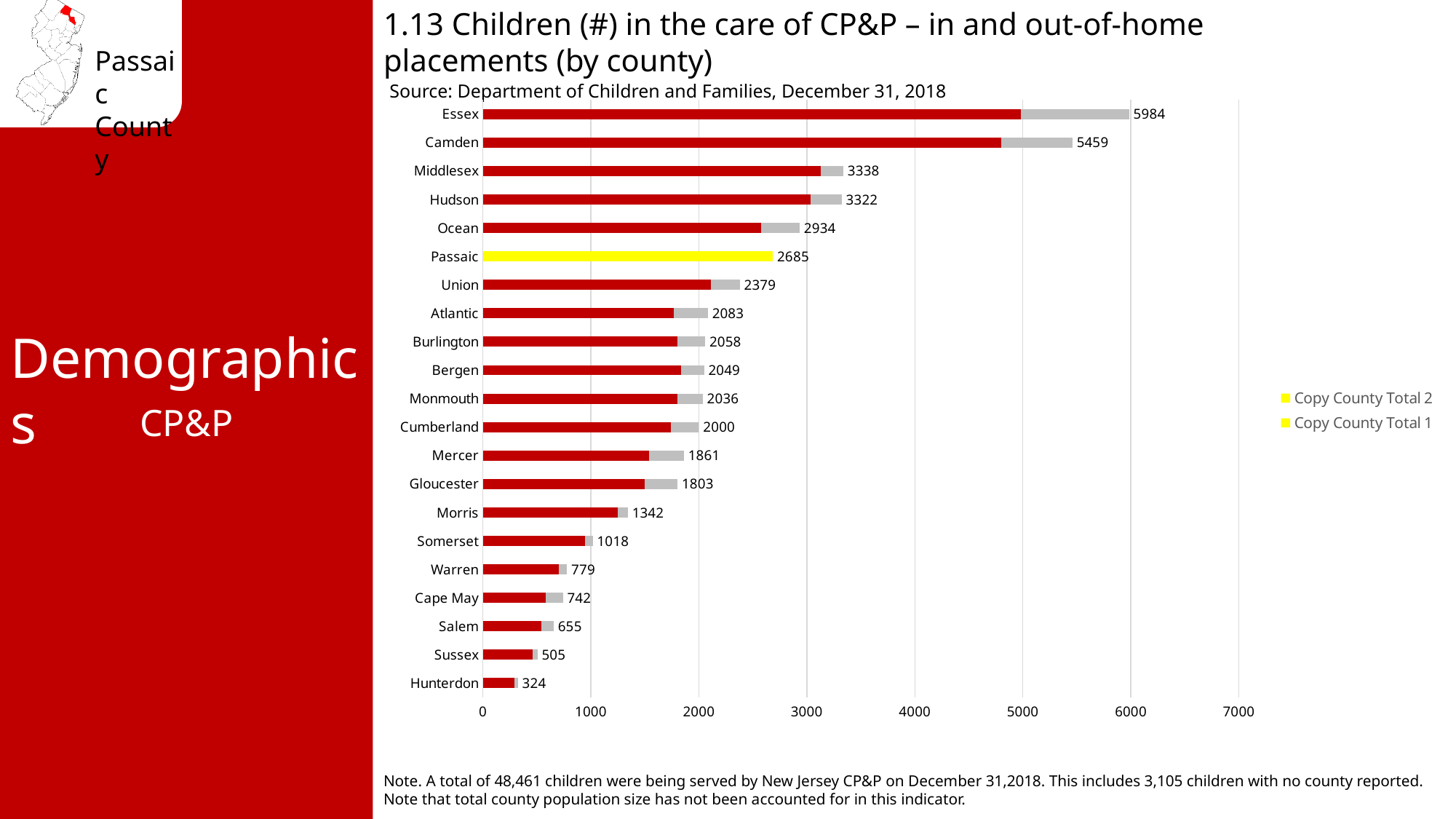
What is the difference between the values for Essex and Camden? 525 Which county has the highest number of children in the care of CP&P? Essex Is the value for Morris greater or less than 1000? greater How many series does the legend list? 2 What is the total number of children in the care of CP&P for Passaic County? 2685 Which county has the lowest number of children in the care of CP&P? Hunterdon What is the difference between the values for Passaic and Union? 306 What kind of chart is shown on the slide? bar chart What is the value shown for Essex County? 5984 How many counties are shown in the chart? 21 Which county has a larger value, Middlesex or Hudson? Middlesex What is the value shown for Hunterdon County? 324